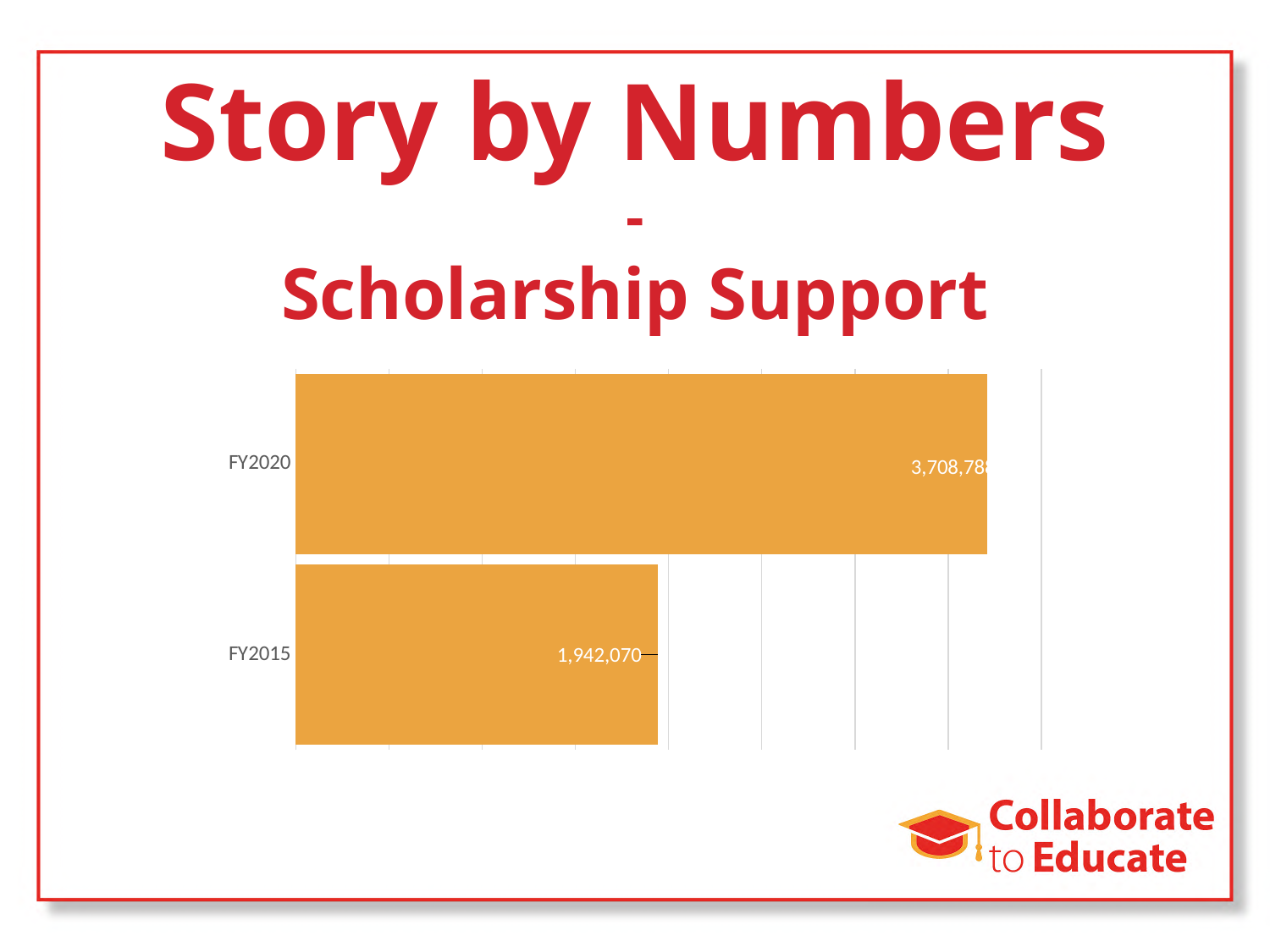
What is the value for FY2015? 1,942,070 How many categories are shown in the chart? 2 What colour are the bars in the chart? Orange Which is larger, the value for FY2020 or the value for FY2015? FY2020 What kind of chart is shown on the slide? Bar chart Which category has the lowest value? FY2015 What is the title of the slide containing the chart? Story by Numbers - Scholarship Support Did scholarship support rise or fall from FY2015 to FY2020? Rise Which category has the highest value? FY2020